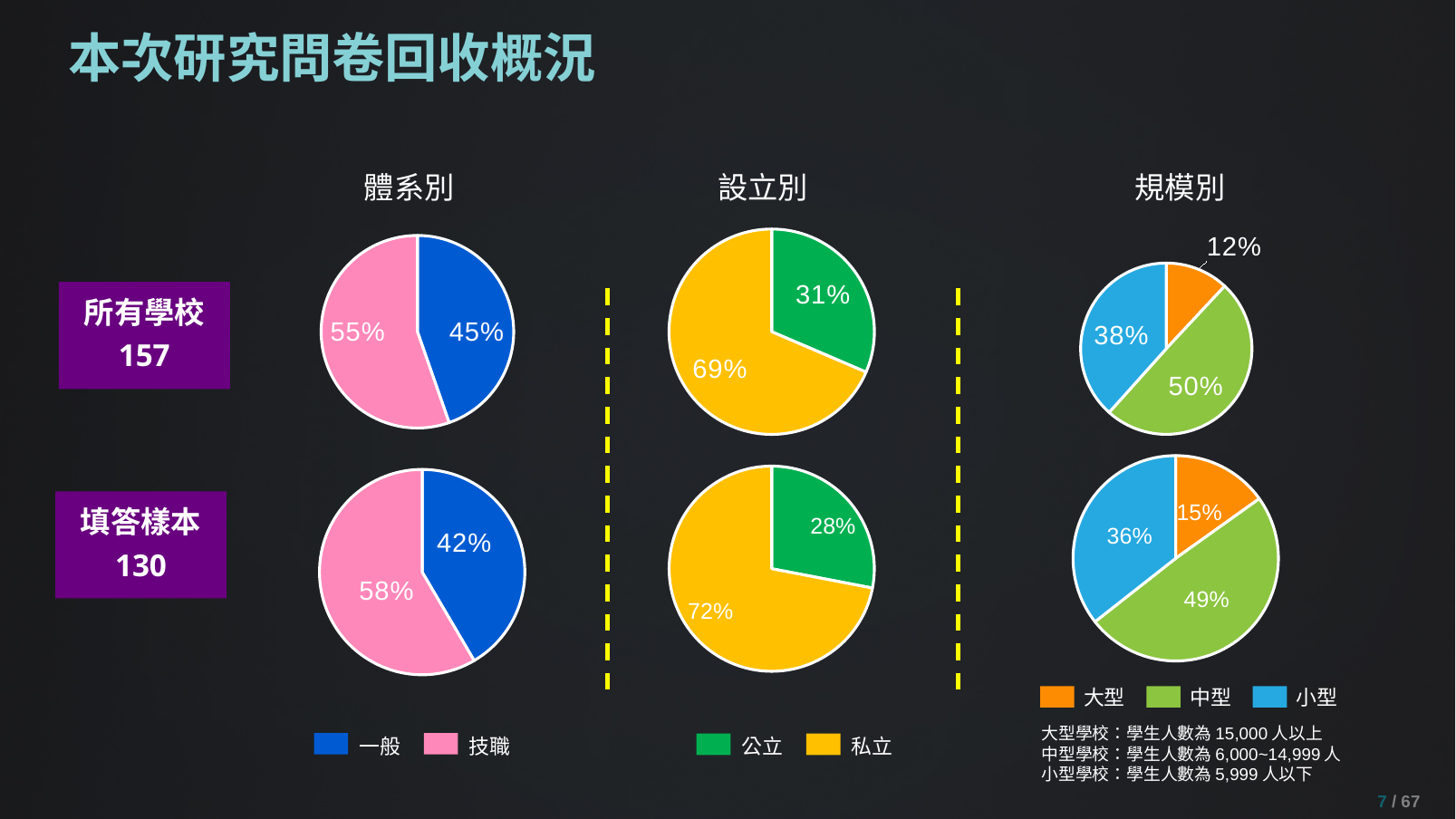
How many pie charts are shown on the slide? 6 In the 體系別 pie chart for 所有學校, which is larger, 一般 or 技職? 技職 In the 規模別 pie chart for 所有學校, which category has the smallest share? 大型 In the 設立別 pie chart for 所有學校, what share is 私立? 69% In the 設立別 pie chart for 填答樣本, what share is 公立? 28% In the 體系別 pie chart for 填答樣本, what share is 技職? 58% How many categories does the legend of the 規模別 charts list? 3 In the 設立別 pie chart for 填答樣本, what is the difference between the 私立 and 公立 shares? 44% In the 體系別 pie chart for 所有學校, what share is 一般? 45% What type of chart is used for 設立別? Pie chart In the 規模別 pie chart for 填答樣本, which category has the largest share? 中型 In the 規模別 pie chart for 所有學校, what share is 大型? 12%